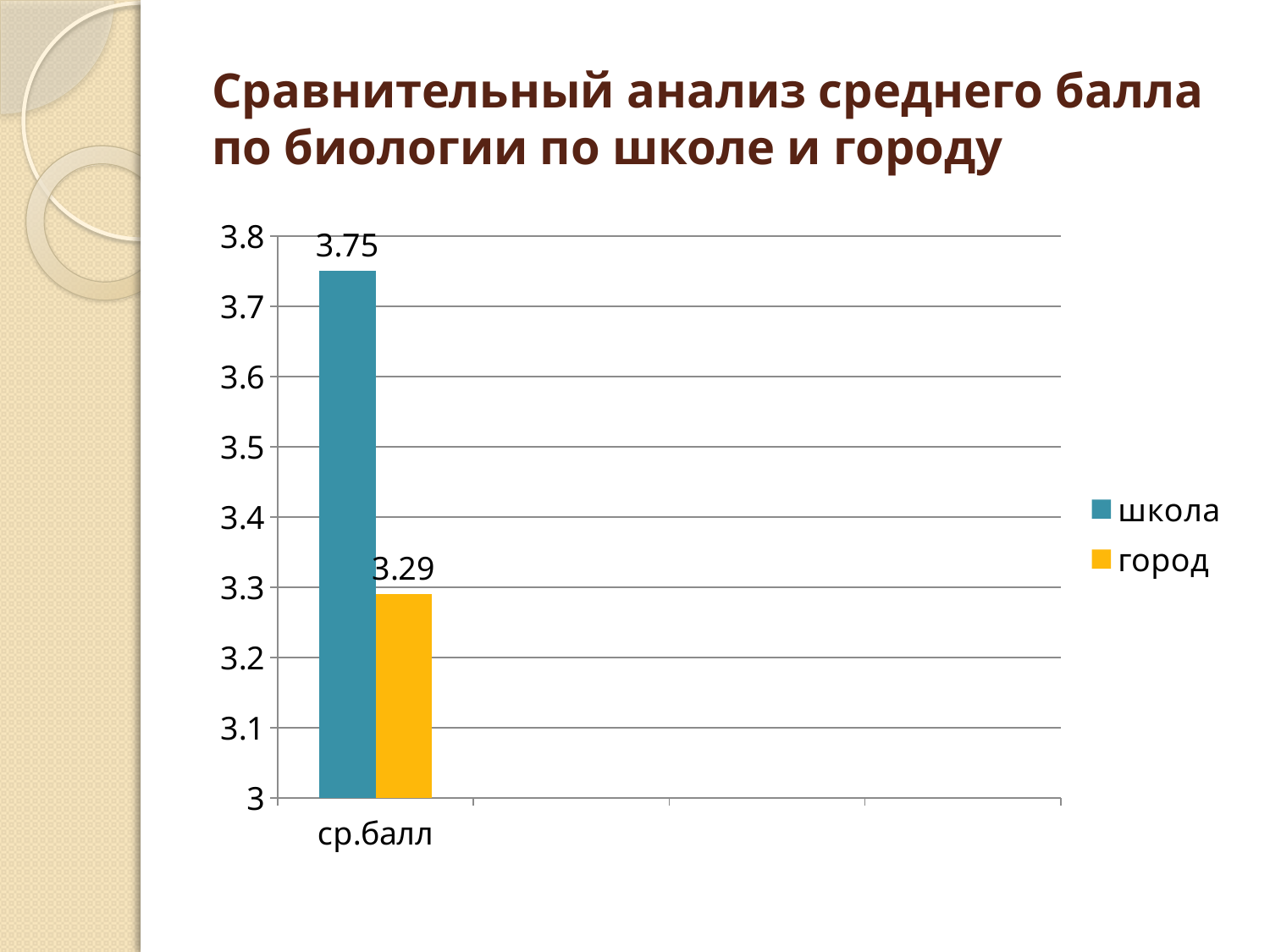
Which series has the lowest value? город How many series does the legend list? 2 Which series has the higher value, школа or город? школа What colour is the bar for город? yellow What is the label of the category on the x axis? ср.балл What is the value for школа? 3.75 How many categories are shown on the x axis? 1 Is the value for школа greater or less than 3.7? greater What is the value for город? 3.29 Is the value for город greater or less than 3.3? less What kind of chart is shown? bar chart What is the difference between the школа and город values? 0.46